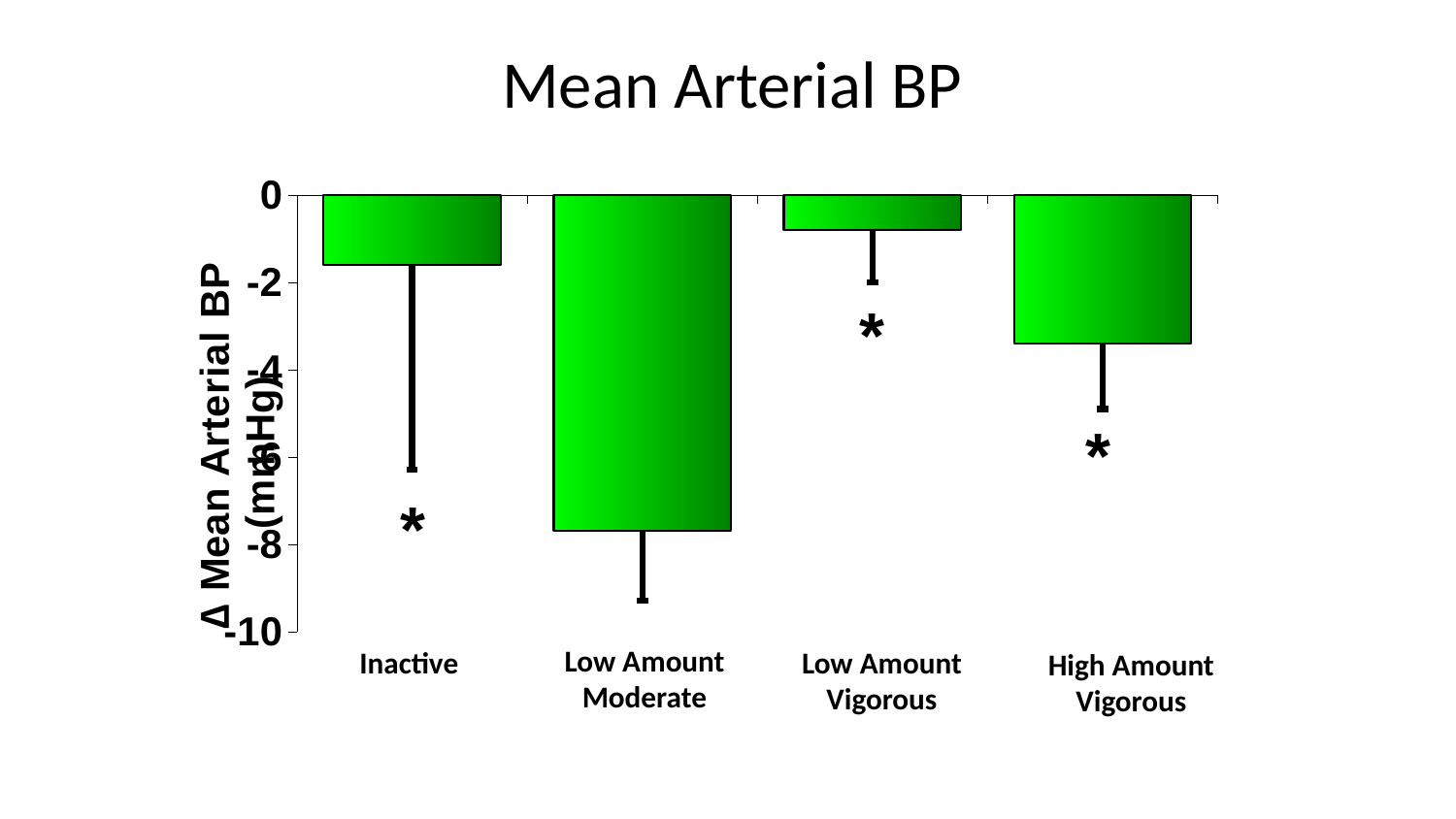
What type of chart is shown on the slide? Bar chart Is the value for High Amount Vigorous greater or less than -4? greater Is the value for Inactive greater or less than -2? greater How many categories are shown on the x axis of the chart? 4 Which category shows the smallest change in mean arterial BP? Low Amount Vigorous Is the value for High Amount Vigorous greater or less than -2? less Which category shows the largest decrease in mean arterial BP? Low Amount Moderate What is the title of the chart? Mean Arterial BP What colour are the bars in the chart? Green Which category shows a larger decrease in mean arterial BP, Inactive or High Amount Vigorous? High Amount Vigorous Which category shows a larger decrease in mean arterial BP, Inactive or Low Amount Vigorous? Inactive